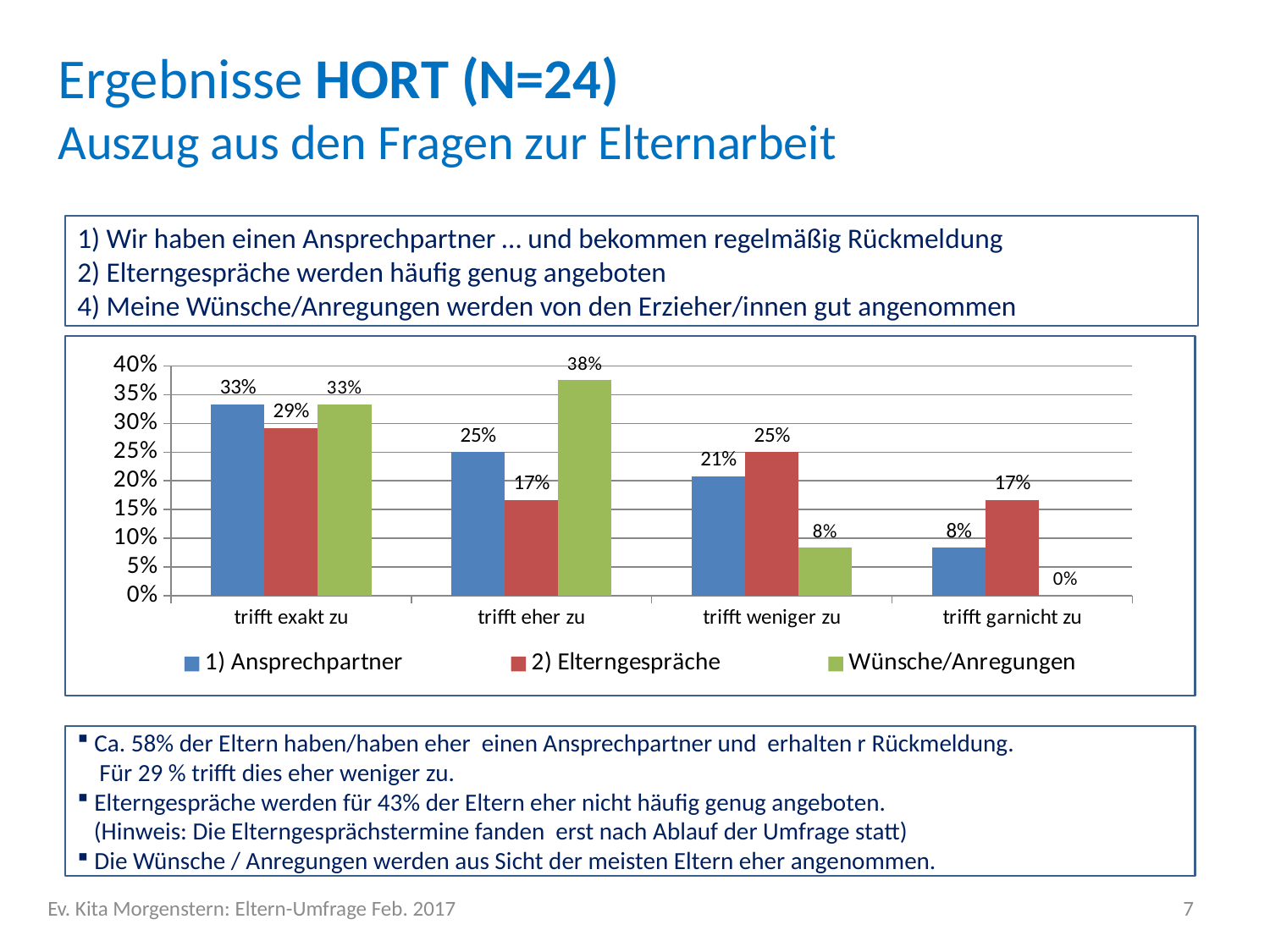
Which series is shown in green in the chart? Wünsche/Anregungen What kind of chart is shown on the slide? bar chart In which category does the series "1) Ansprechpartner" have its lowest value? trifft garnicht zu What is the value for "2) Elterngespräche" in the category "trifft exakt zu"? 29% What is the value for "1) Ansprechpartner" in the category "trifft weniger zu"? 21% How many series does the chart legend list? 3 In the category "trifft weniger zu", which series has the larger value: "1) Ansprechpartner" or "2) Elterngespräche"? 2) Elterngespräche What is the difference between the values for "Wünsche/Anregungen" and "2) Elterngespräche" in the category "trifft eher zu"? 21% What is the value for "Wünsche/Anregungen" in the category "trifft eher zu"? 38% What is the value for "Wünsche/Anregungen" in the category "trifft garnicht zu"? 0% In which category does the series "Wünsche/Anregungen" reach its highest value? trifft eher zu How many categories are shown on the x axis of the chart? 4